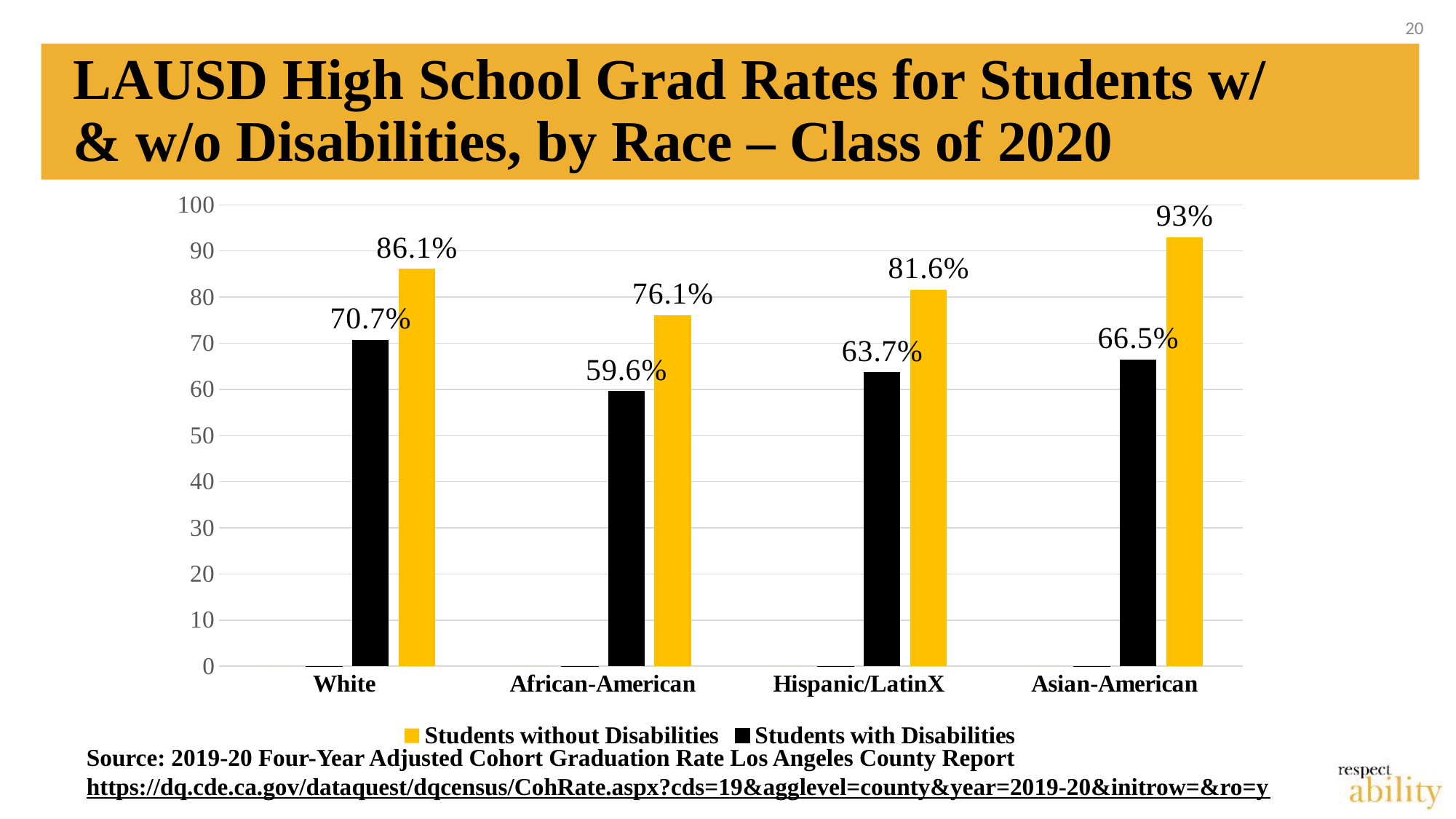
What is the graduation rate for Asian-American students without disabilities? 93% How many series does the legend list? 2 Which colour represents Students with Disabilities in the chart? Black Which is larger: the graduation rate for White students with disabilities or for Asian-American students with disabilities? White students with disabilities How many race categories are shown on the x axis? 4 Which race has the lowest graduation rate for students with disabilities? African-American What kind of chart is shown on the slide? Bar chart What is the difference between the graduation rates of Asian-American students without disabilities and with disabilities? 26.5 percentage points What is the graduation rate for Hispanic/LatinX students with disabilities? 63.7% What is the graduation rate for White students with disabilities? 70.7% What is the difference between the graduation rates of African-American students without disabilities and with disabilities? 16.5 percentage points Which race has the highest graduation rate for students without disabilities? Asian-American